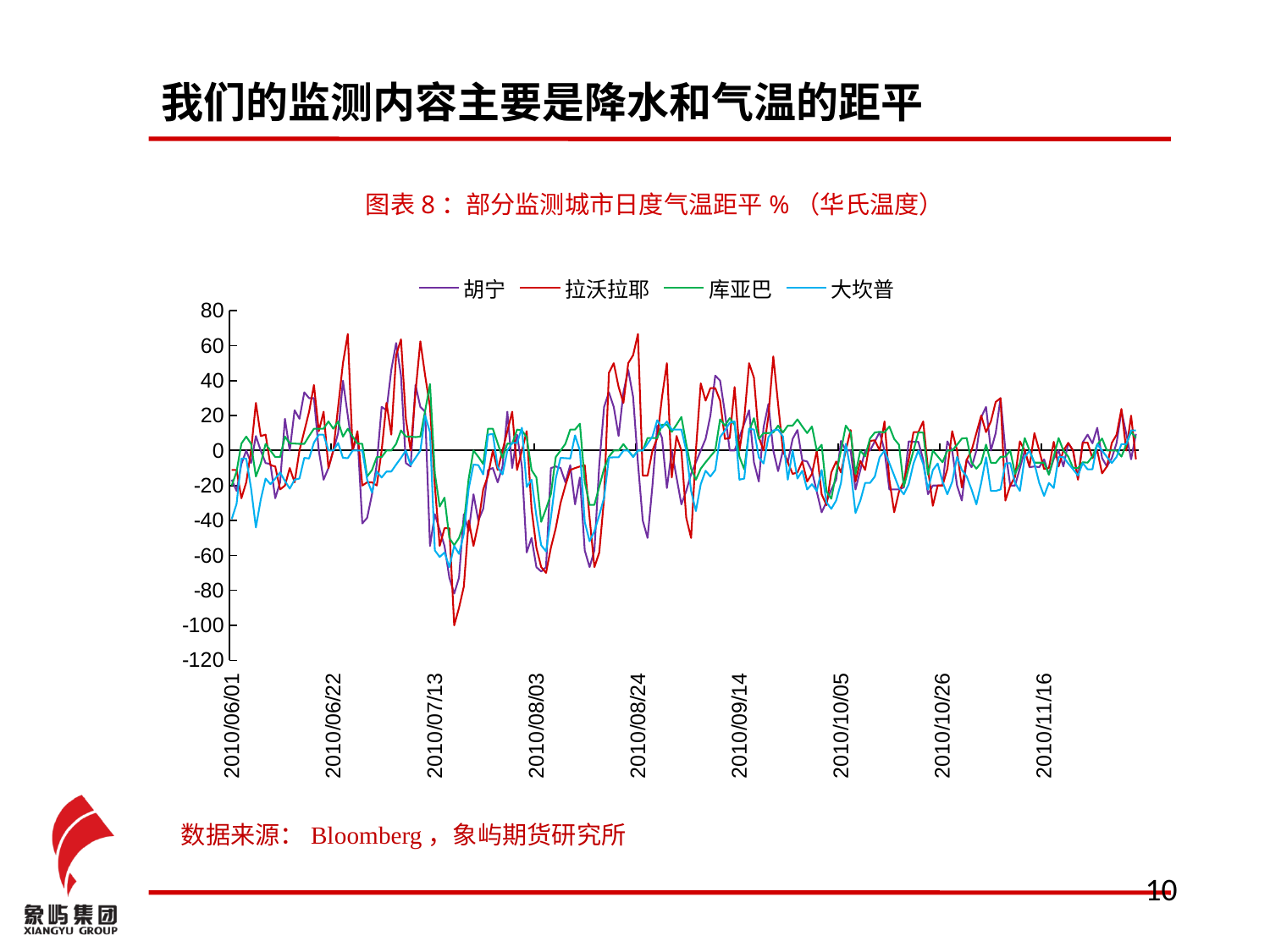
Which series reaches the lowest value on the chart? 拉沃拉耶 What is the first date label on the x axis? 2010/06/01 Is the lowest value reached by 拉沃拉耶 greater or less than -80? less Do the fluctuations of the lines become larger or smaller from June to November 2010? Smaller What is the title of the chart? 图表8：部分监测城市日度气温距平 %（华氏温度） What is the highest value shown on the y axis? 80 What is the lowest value shown on the y axis? -120 What kind of chart is shown on the slide? Line chart How many series does the legend list? 4 Which colour is used for the 拉沃拉耶 line? Red Is the highest value reached by 拉沃拉耶 greater or less than 60? greater How many date labels are shown on the x axis? 9